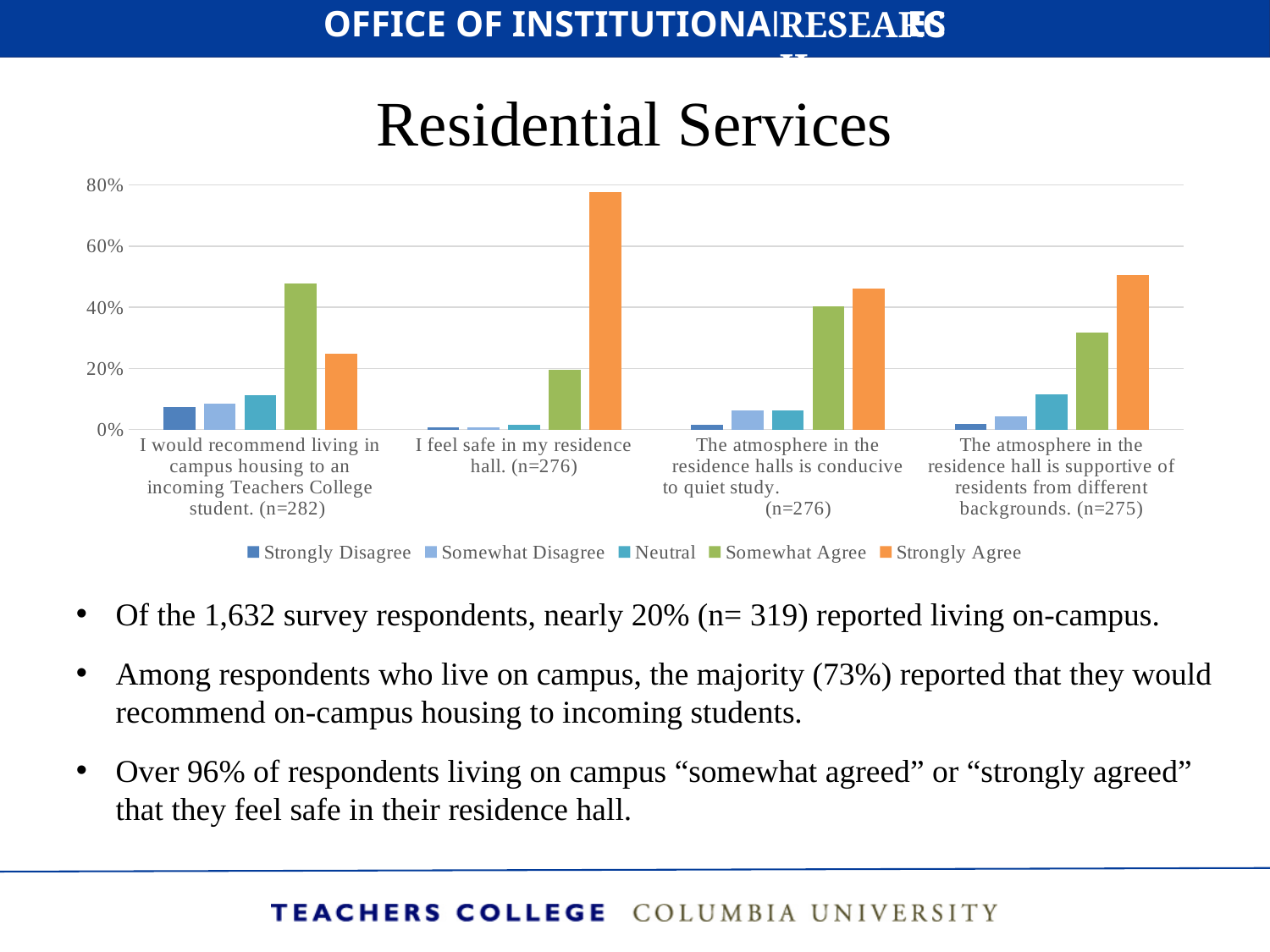
For "The atmosphere in the residence hall is supportive of residents from different backgrounds. (n=275)", which is larger: Somewhat Agree or Strongly Agree? Strongly Agree Is the Strongly Agree value for "I feel safe in my residence hall. (n=276)" greater or less than 60%? greater Is the Strongly Agree value for "The atmosphere in the residence hall is supportive of residents from different backgrounds. (n=275)" greater or less than 40%? greater What kind of chart is shown on the slide? Bar chart What colour represents the Strongly Agree series in the chart? Orange Which statement has the lowest Somewhat Agree value? I feel safe in my residence hall. (n=276) Is the Somewhat Agree value for "I would recommend living in campus housing to an incoming Teachers College student. (n=282)" greater or less than 40%? greater Which statement has the highest Strongly Agree value? I feel safe in my residence hall. (n=276) How many series does the legend list? 5 How many survey statements (categories) are plotted on the x axis? 4 For "I would recommend living in campus housing to an incoming Teachers College student. (n=282)", which is larger: Somewhat Agree or Strongly Agree? Somewhat Agree For "I feel safe in my residence hall. (n=276)", which is larger: Somewhat Agree or Strongly Agree? Strongly Agree